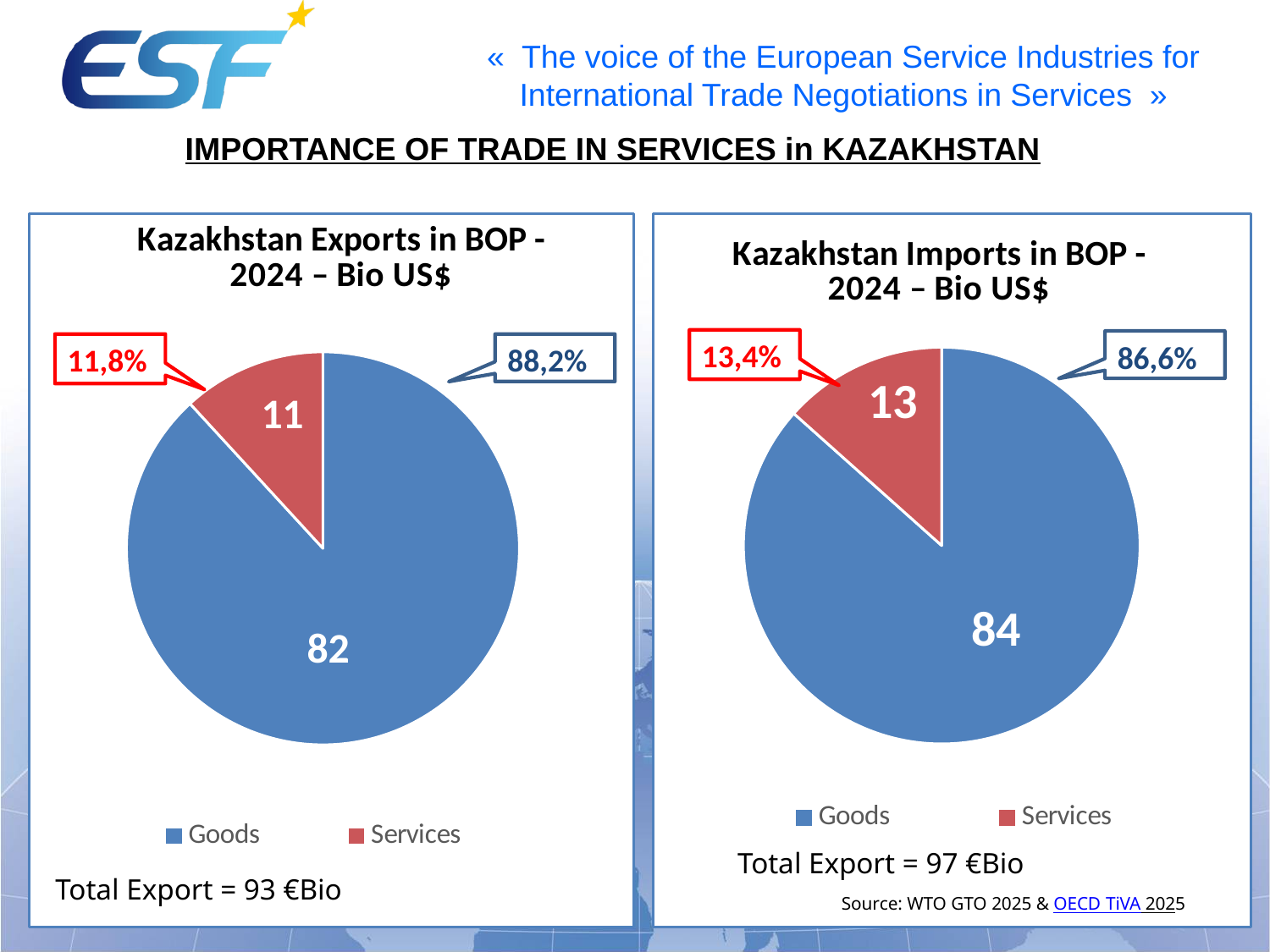
In the Kazakhstan Exports in BOP chart, what share of the pie does Services represent? 11,8% What type of chart is the Kazakhstan Imports in BOP chart? Pie chart In the Kazakhstan Imports in BOP chart, what share of the pie does Goods represent? 86,6% In the Kazakhstan Exports in BOP chart, which category is the largest? Goods In the Kazakhstan Imports in BOP chart, what is the value for Services? 13 In the Kazakhstan Imports in BOP chart, which category is the smallest? Services In the Kazakhstan Exports in BOP chart, what is the difference between the Goods and Services values? 71 In the Kazakhstan Exports in BOP chart, what is the value for Goods? 82 In the Kazakhstan Exports in BOP chart, what is the value for Services? 11 How many categories does the legend of the Kazakhstan Exports in BOP chart list? 2 Is the Services value larger in the Kazakhstan Exports chart or the Kazakhstan Imports chart? Kazakhstan Imports In the Kazakhstan Imports in BOP chart, what is the value for Goods? 84